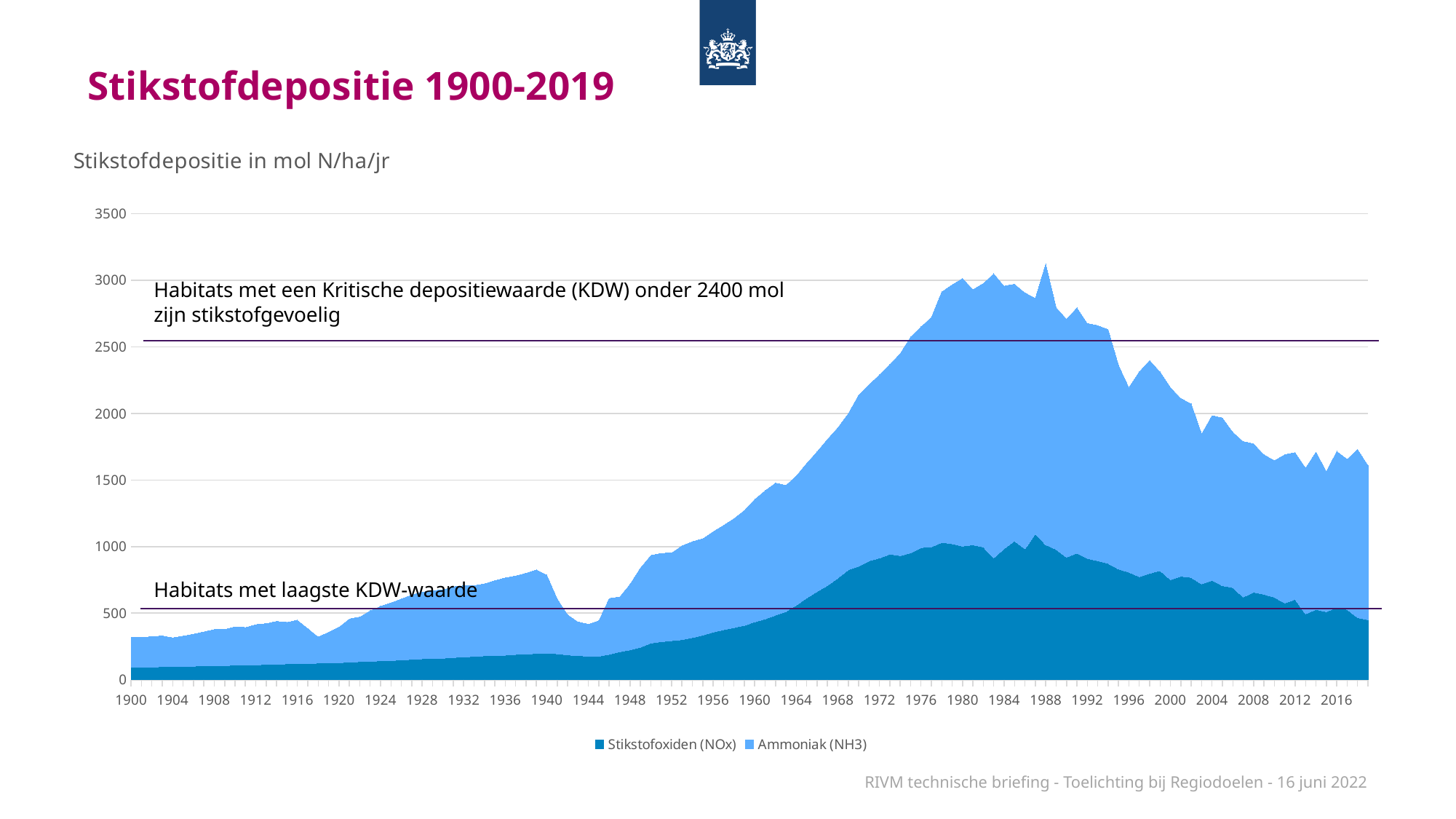
Is the total stikstofdepositie in 1960 greater or less than 1500? less Is the Stikstofoxiden (NOx) value in 1980 greater or less than 500? greater Is the total stikstofdepositie in 1980 greater or less than 2500? greater Does the total stikstofdepositie rise or fall between 1988 and 2016? fall How many series does the legend list? 2 What kind of chart is shown on the slide? Stacked area chart Which two series are listed in the legend? Stikstofoxiden (NOx) and Ammoniak (NH3) What is the title of the chart? Stikstofdepositie in mol N/ha/jr Does the total stikstofdepositie rise or fall between 1948 and 1980? rise